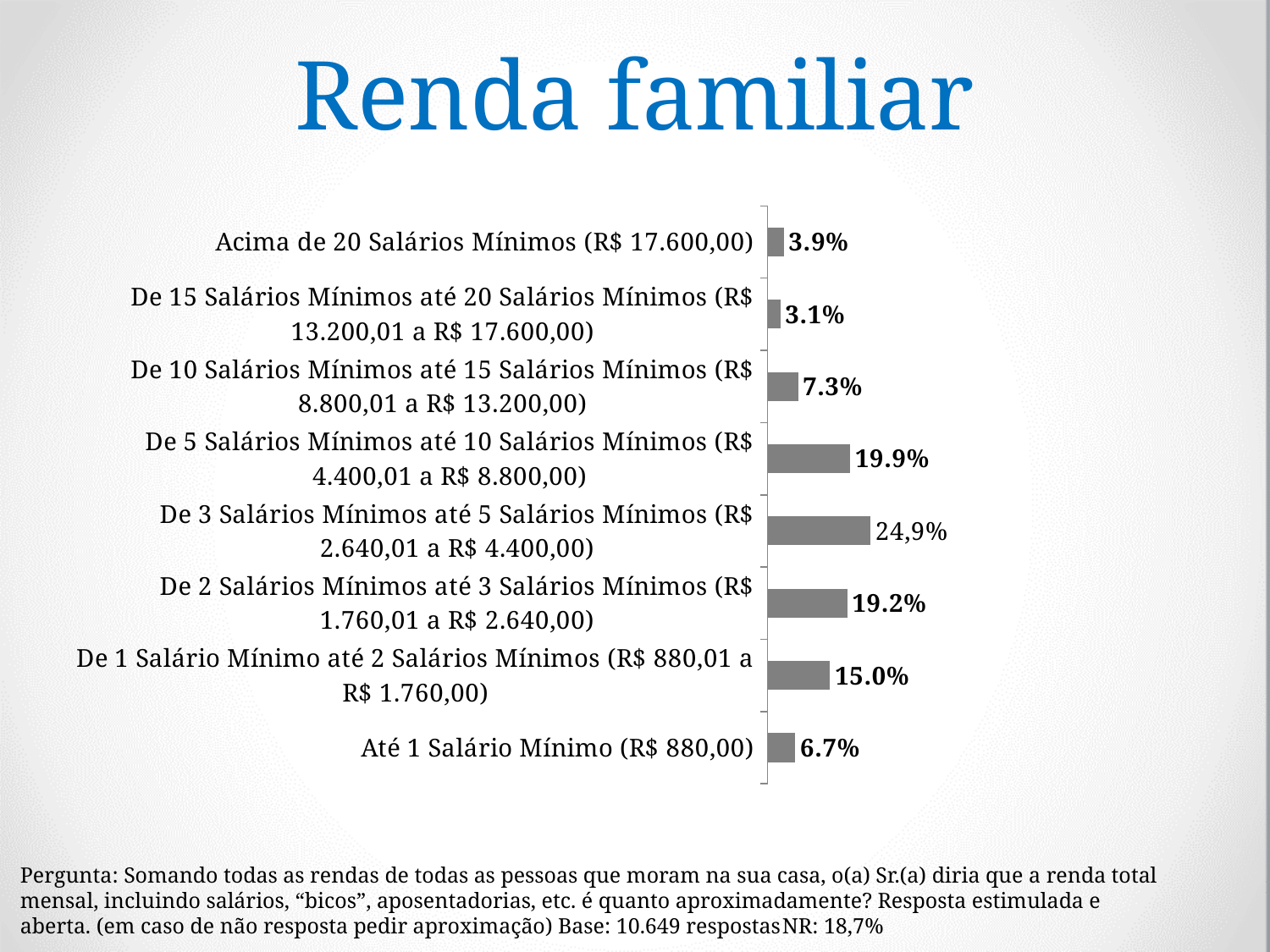
How many income categories are shown in the chart? 8 Which is larger: the value for 'Até 1 Salário Mínimo (R$ 880,00)' or the value for 'De 10 Salários Mínimos até 15 Salários Mínimos'? De 10 Salários Mínimos até 15 Salários Mínimos What is the value for 'De 1 Salário Mínimo até 2 Salários Mínimos (R$ 880,01 a R$ 1.760,00)'? 15.0% What is the difference between the values for 'De 10 Salários Mínimos até 15 Salários Mínimos' and 'Acima de 20 Salários Mínimos'? 3.4% What type of chart is shown on the slide? Bar chart What is the value for 'De 5 Salários Mínimos até 10 Salários Mínimos (R$ 4.400,01 a R$ 8.800,00)'? 19.9% Which income category has the highest value? De 3 Salários Mínimos até 5 Salários Mínimos (R$ 2.640,01 a R$ 4.400,00) What is the value for 'Acima de 20 Salários Mínimos (R$ 17.600,00)'? 3.9% What is the difference between the values for 'De 5 Salários Mínimos até 10 Salários Mínimos' and 'De 2 Salários Mínimos até 3 Salários Mínimos'? 0.7% Which income category has the lowest value? De 15 Salários Mínimos até 20 Salários Mínimos (R$ 13.200,01 a R$ 17.600,00) What is the title of the slide? Renda familiar What is the value for 'Até 1 Salário Mínimo (R$ 880,00)'? 6.7%